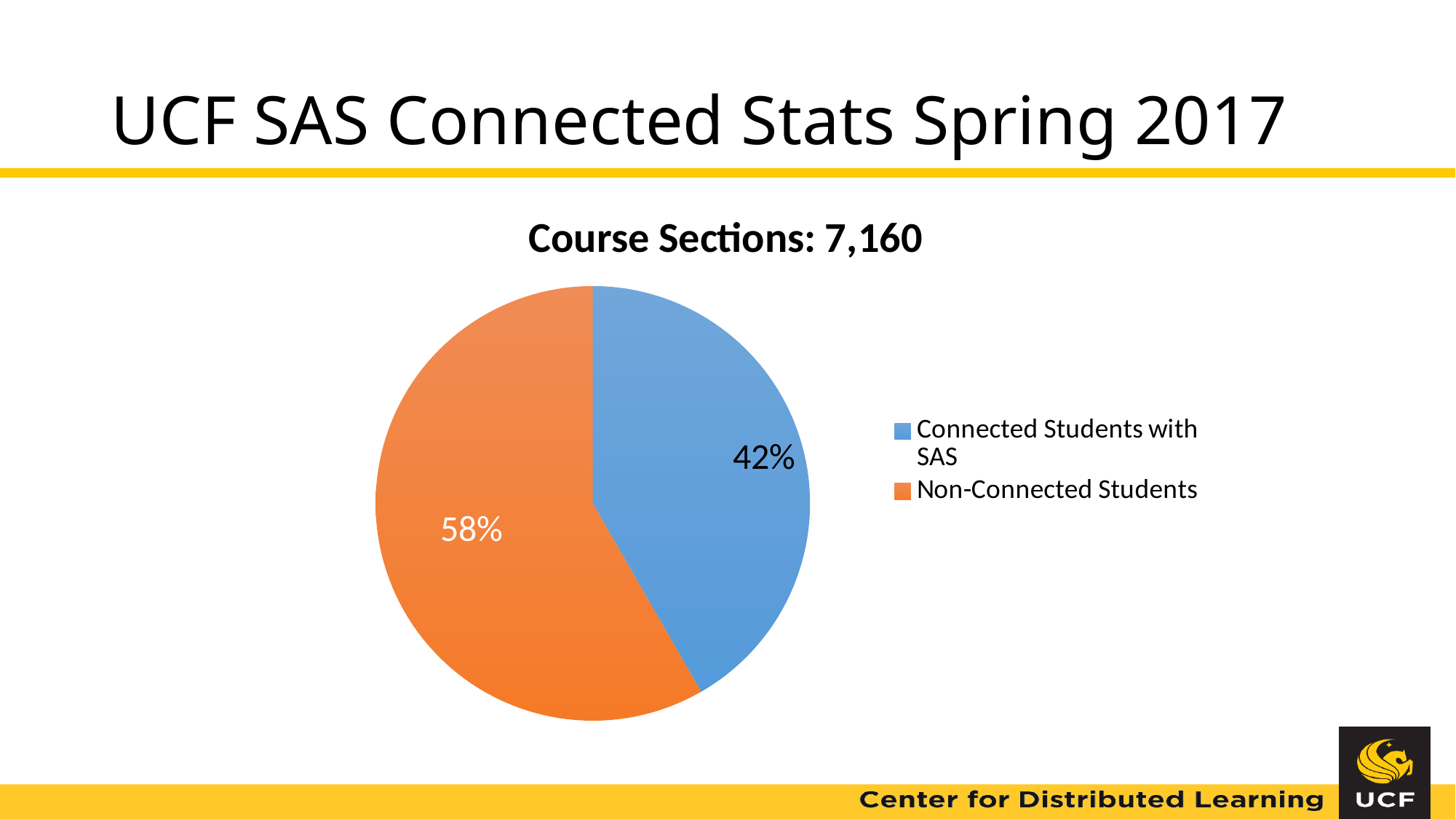
What is the difference in percentage points between Non-Connected Students and Connected Students with SAS? 16 Which slice is the largest? Non-Connected Students What is the title of the chart? Course Sections: 7,160 What type of chart is shown on the slide? Pie chart How many slices does the pie chart have? 2 What percentage of the pie is Connected Students with SAS? 42% How many entries does the legend list? 2 Which slice is the smallest? Connected Students with SAS What colour is the Non-Connected Students slice? Orange What percentage of the pie is Non-Connected Students? 58% What share of the pie does the Connected Students with SAS slice take? 42% Which is larger, the share for Connected Students with SAS or the share for Non-Connected Students? Non-Connected Students